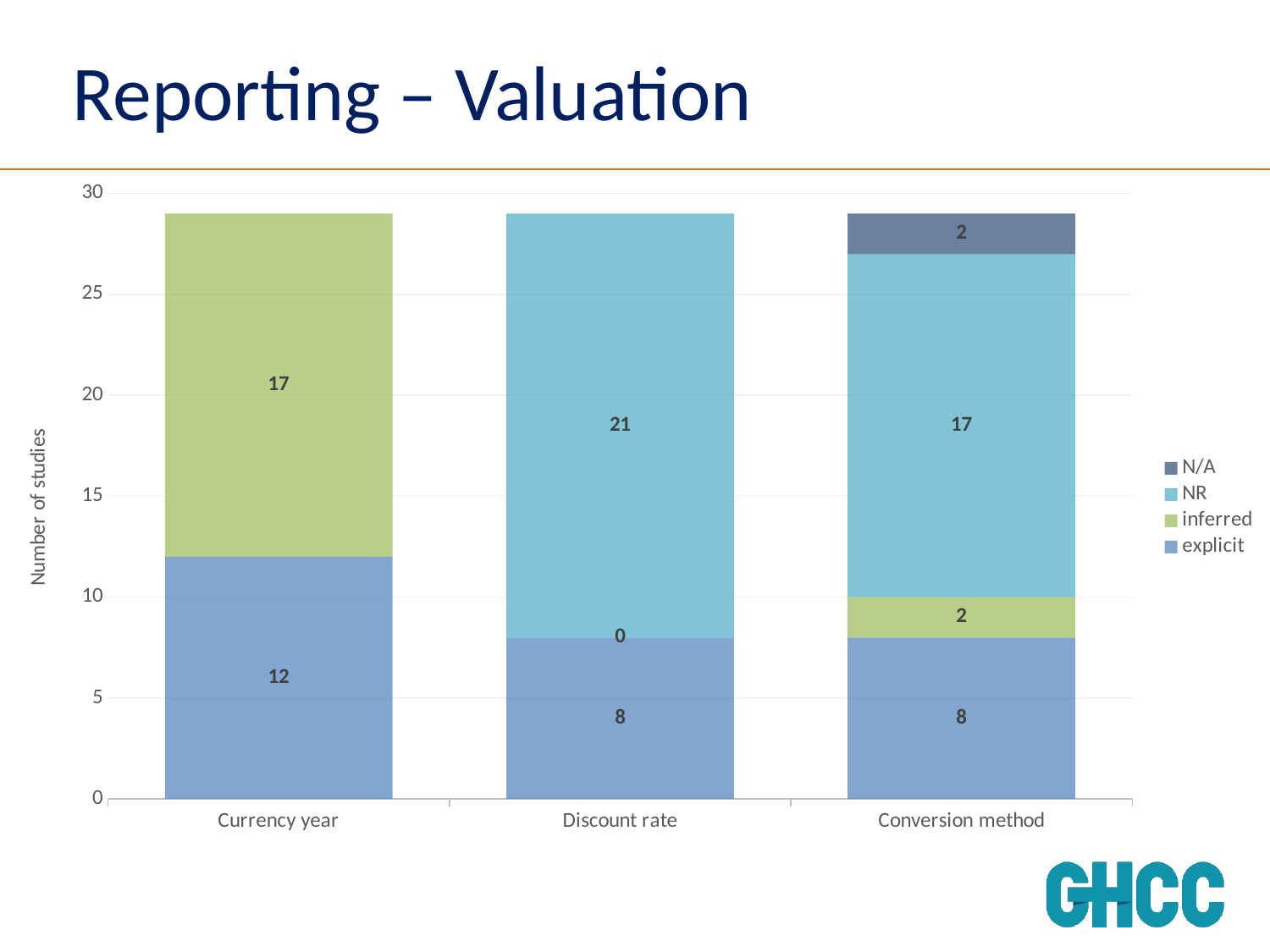
What is the value of the inferred segment for Discount rate? 0 Which is larger: the explicit value for Currency year or the explicit value for Discount rate? Currency year What kind of chart is shown on the slide? Stacked bar chart What is the value of the NR segment for Discount rate? 21 What is the value of the N/A segment for Conversion method? 2 What is the difference between the NR value for Discount rate and the NR value for Conversion method? 4 What is the total of the stacked bar for Conversion method? 29 What is the label of the y axis? Number of studies How many series does the legend list? 4 How many categories are shown on the x axis? 3 What is the value of the explicit segment for Currency year? 12 Which category has the largest inferred segment? Currency year